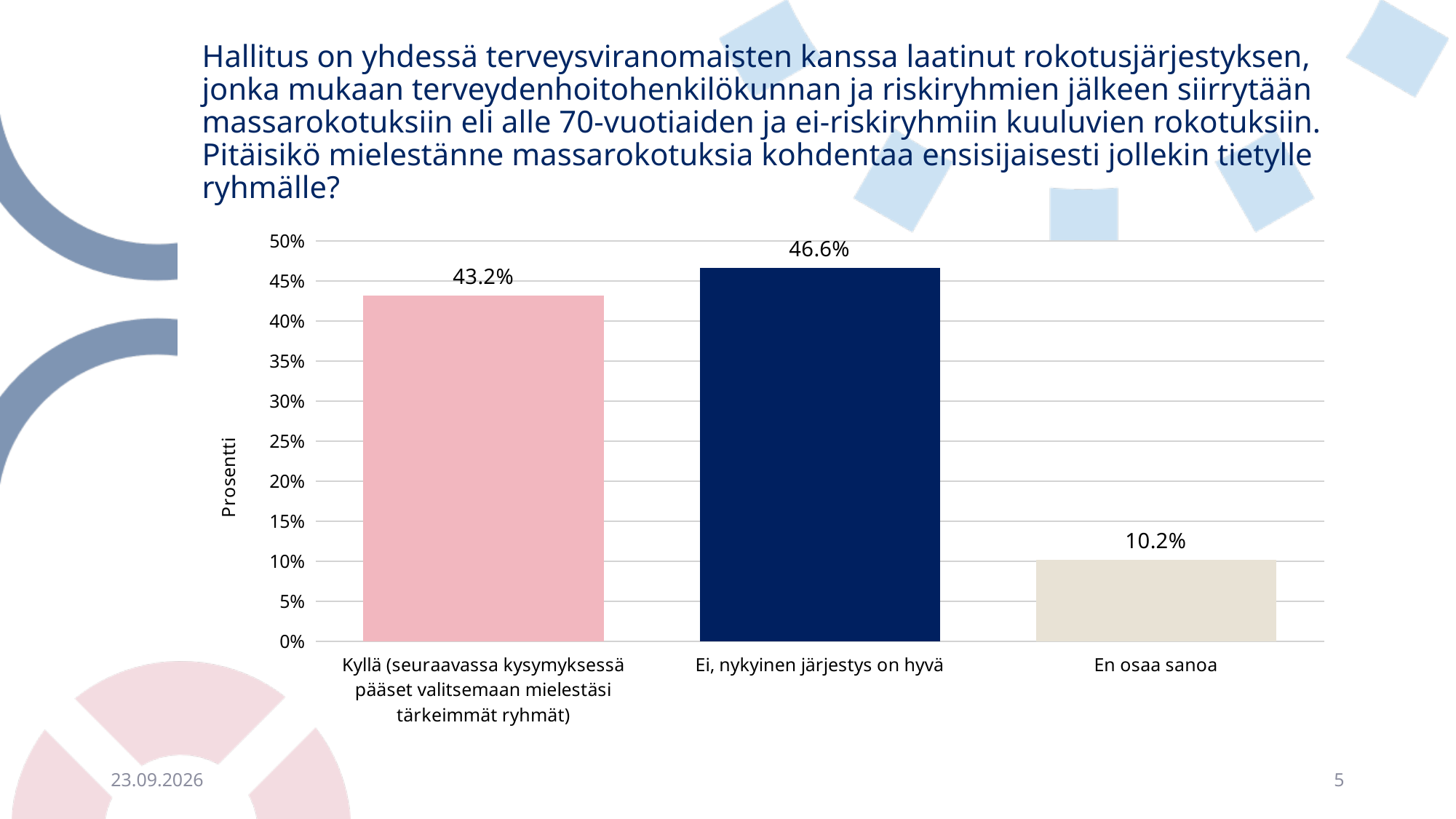
What is the difference between the values for "Ei, nykyinen järjestys on hyvä" and "Kyllä"? 3.4% What is the value for "En osaa sanoa"? 10.2% Is the value for "En osaa sanoa" greater or less than 15%? less How many categories are shown in the chart? 3 What kind of chart is shown on the slide? bar chart What is the value for the "Kyllä" category? 43.2% What is the difference between the values for "Kyllä" and "En osaa sanoa"? 33.0% Which category has the lowest value? En osaa sanoa What is the value for "Ei, nykyinen järjestys on hyvä"? 46.6% Which category has the highest value? Ei, nykyinen järjestys on hyvä Which is larger, the value for "Kyllä" or the value for "En osaa sanoa"? Kyllä What is the label of the vertical axis? Prosentti